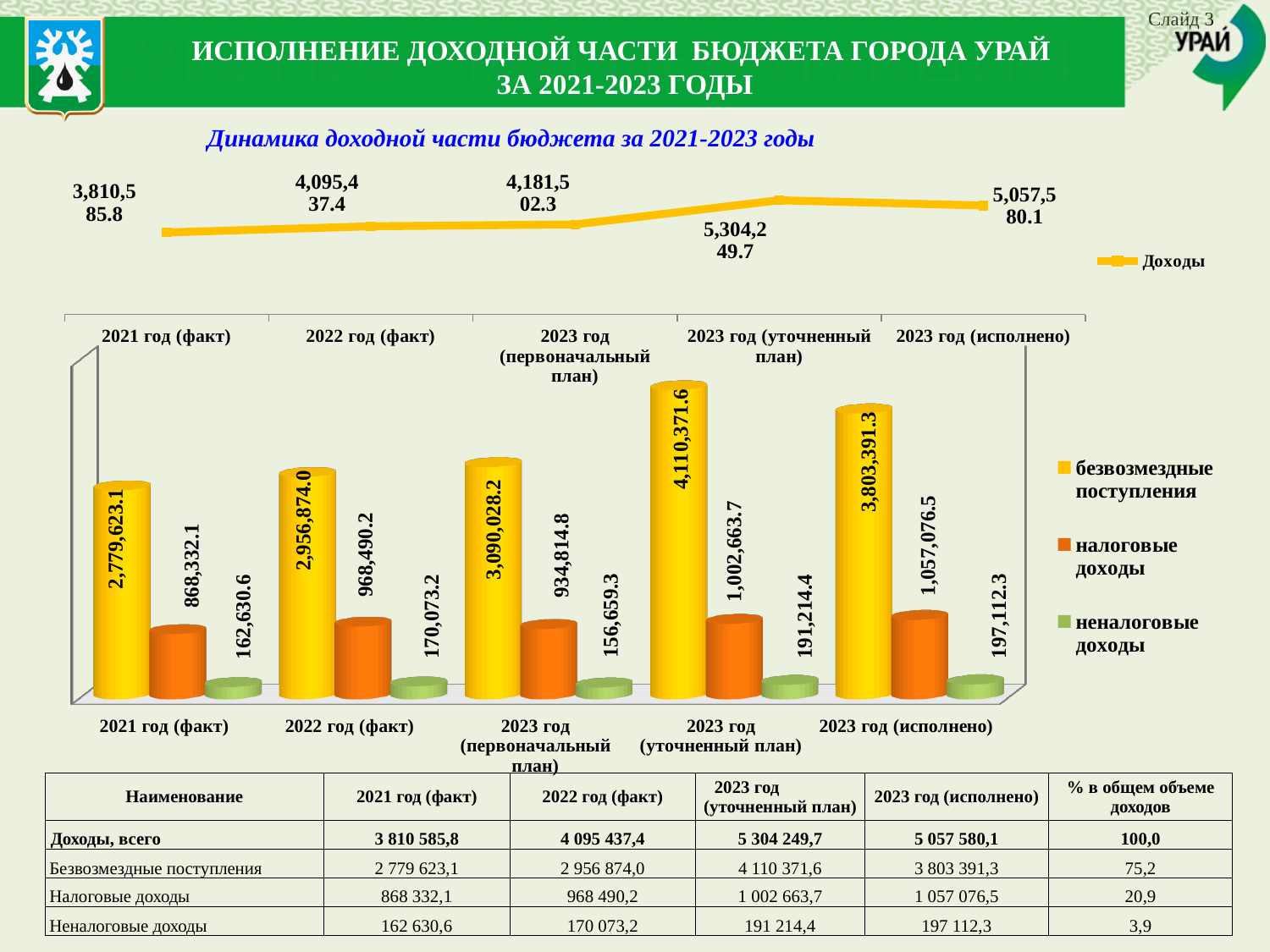
How many categories are shown on the x axis of the lower bar chart? 5 What kind of chart is the lower chart on the slide? bar chart In the lower bar chart, what is the difference between безвозмездные поступления for 2023 год (уточненный план) and 2023 год (исполнено)? 306,980.3 In the lower bar chart, which category has the highest value for безвозмездные поступления? 2023 год (уточненный план) In the lower bar chart, which category has the lowest value for неналоговые доходы? 2023 год (первоначальный план) In the upper line chart 'Динамика доходной части бюджета за 2021-2023 годы', does the line rise or fall between the first point and the last point? rises How many series does the legend of the lower bar chart list? 3 In the lower bar chart, what is the difference between налоговые доходы for 2023 год (исполнено) and 2023 год (уточненный план)? 54,412.8 In the lower bar chart, what is the value of налоговые доходы for 2022 год (факт)? 968,490.2 What series name is shown in the legend of the upper line chart? Доходы In the lower bar chart, what is the value of безвозмездные поступления for 2023 год (исполнено)? 3,803,391.3 In the lower bar chart, which is larger: неналоговые доходы for 2021 год (факт) or for 2022 год (факт)? 2022 год (факт)